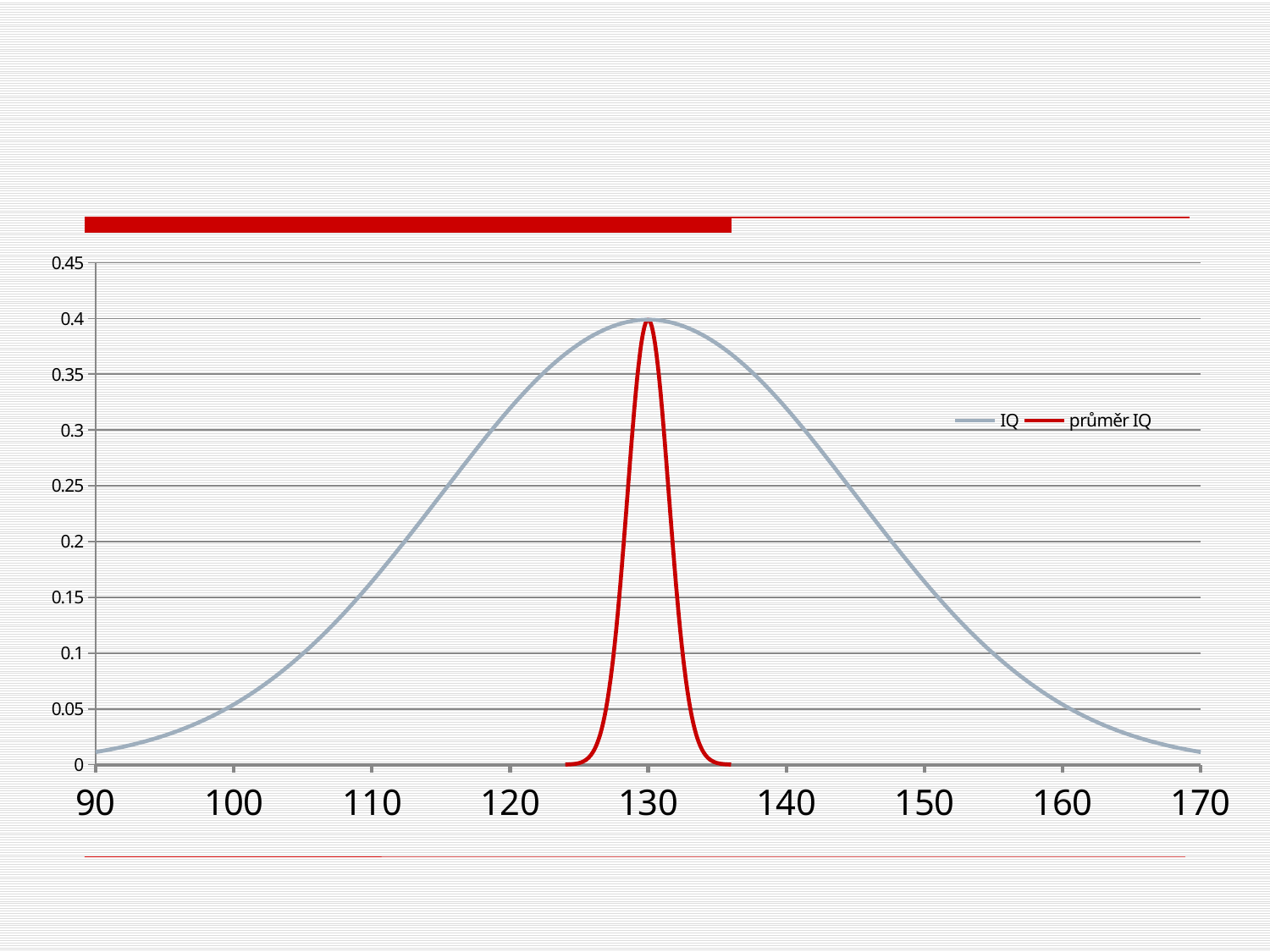
Is the value of the průměr IQ series at 120 greater or less than 0.05? less Does the IQ series rise or fall between 90 and 130 on the x axis? rise Does the IQ series rise or fall between 130 and 170 on the x axis? fall Is the value of the IQ series at 170 greater or less than 0.05? less What are the two series named in the legend? IQ and průměr IQ At which x-axis value does the průměr IQ series reach its highest point? 130 Is the value of the IQ series at 130 greater or less than 0.35? greater What kind of chart is shown on the slide? line chart How many series does the legend list? 2 At which x-axis value does the IQ series reach its highest point? 130